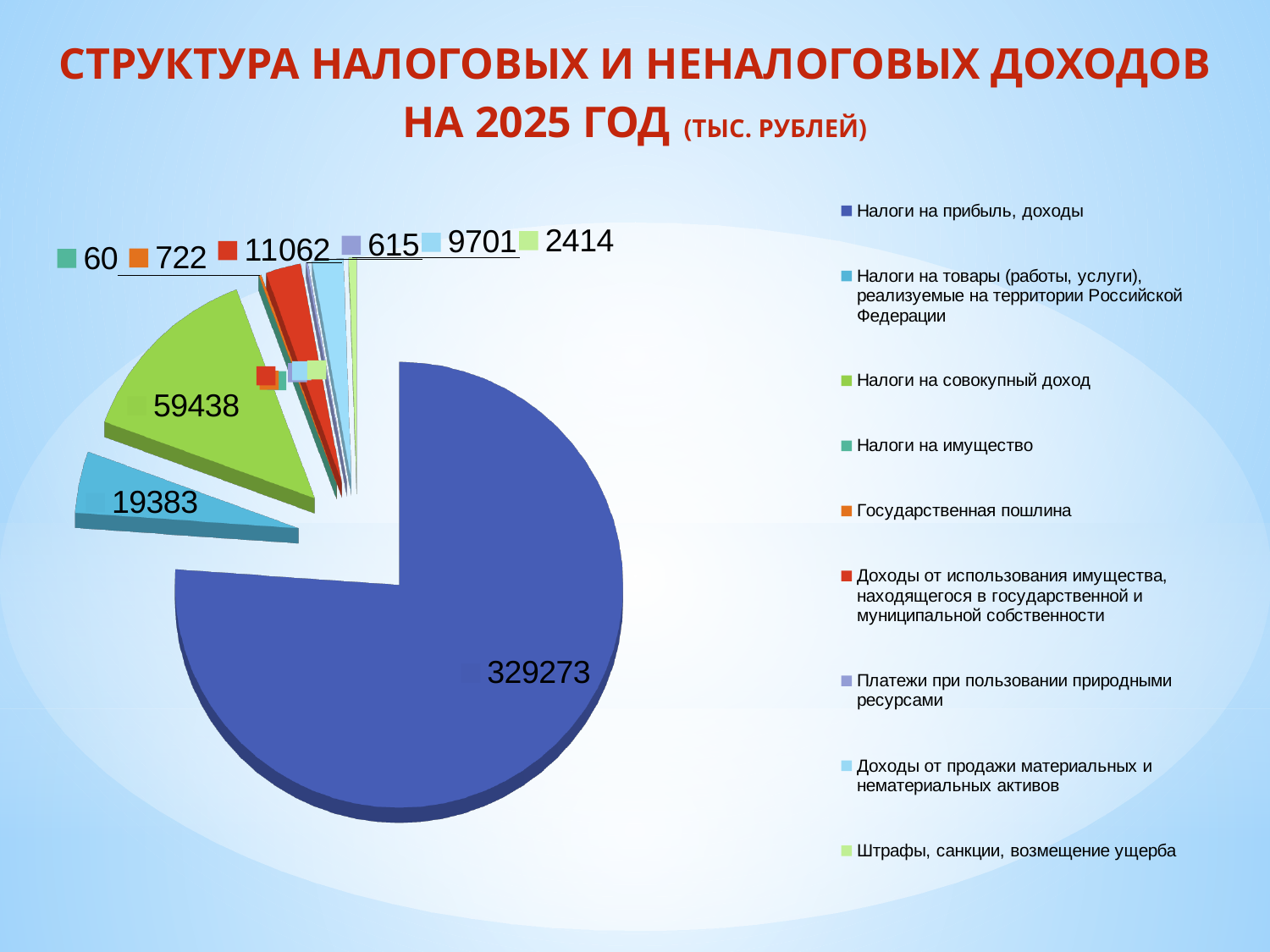
What is the value for Штрафы, санкции, возмещение ущерба? 2414 What is the value for Налоги на товары (работы, услуги), реализуемые на территории Российской Федерации? 19383 Which is larger: Государственная пошлина or Платежи при пользовании природными ресурсами? Государственная пошлина What is the value for Налоги на прибыль, доходы? 329273 How many slices does the pie chart have? 9 What type of chart is shown on the slide? pie chart What is the value for Доходы от использования имущества, находящегося в государственной и муниципальной собственности? 11062 What is the difference between the values for Налоги на совокупный доход and Налоги на товары (работы, услуги), реализуемые на территории Российской Федерации? 40055 Which category has the smallest value? Налоги на имущество What is the value for Налоги на совокупный доход? 59438 Which category has the largest slice of the pie? Налоги на прибыль, доходы How many entries does the legend list? 9